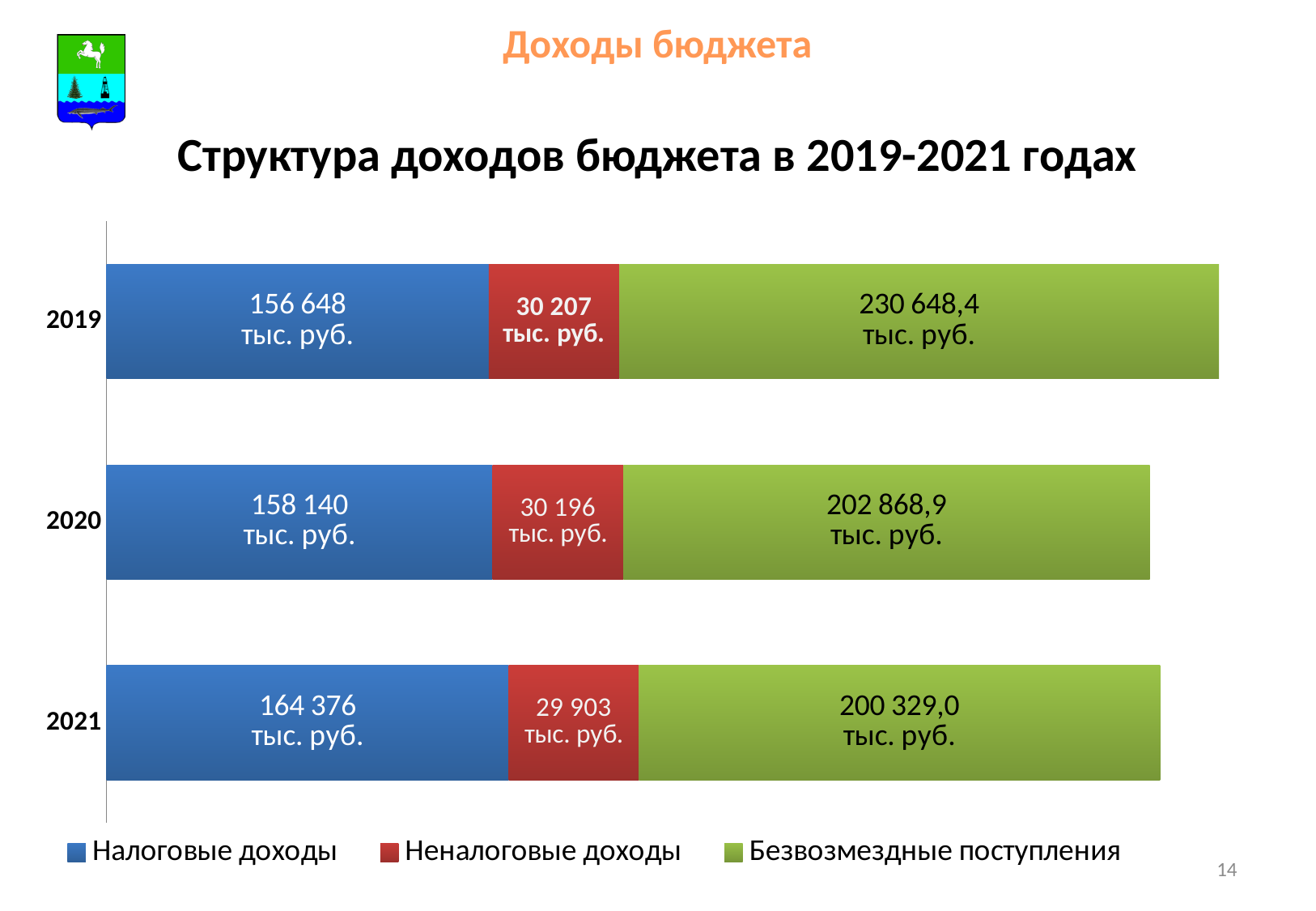
What is the value of Неналоговые доходы for 2021? 29 903 тыс. руб. Which is larger: Неналоговые доходы in 2019 or in 2021? 2019 In which year are Безвозмездные поступления the lowest? 2021 What is the value of Налоговые доходы for 2019? 156 648 тыс. руб. How many years are shown on the chart? 3 What type of chart is shown on the slide? Stacked bar chart What is the difference between Безвозмездные поступления in 2019 and in 2020? 27 779,5 тыс. руб. What is the difference between Налоговые доходы in 2021 and in 2019? 7 728 тыс. руб. What is the value of Безвозмездные поступления for 2020? 202 868,9 тыс. руб. In which year are Налоговые доходы the highest? 2021 How many series does the legend list? 3 What is the total of the stacked bar for 2019? 417 503,4 тыс. руб.